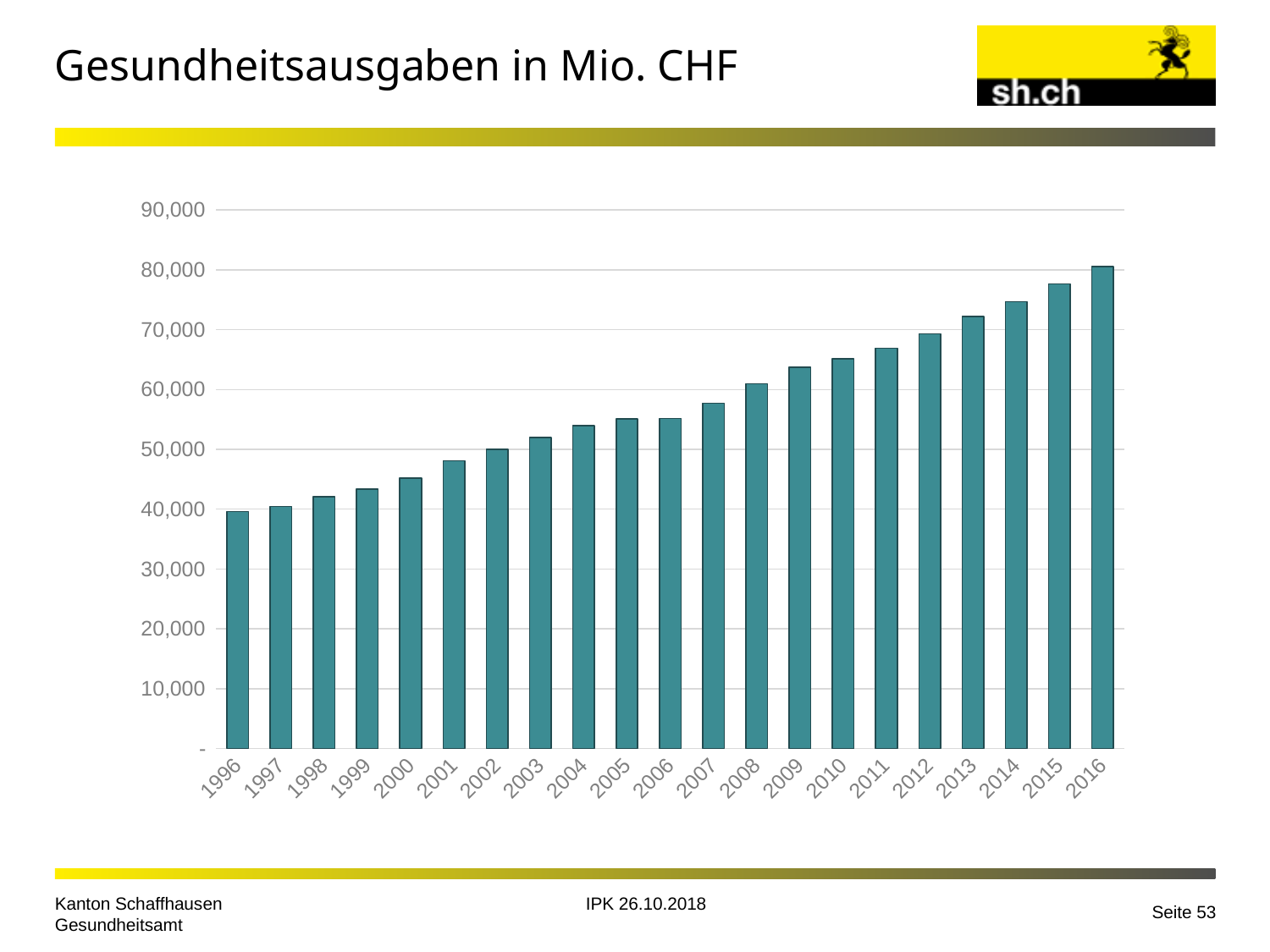
What kind of chart is shown on the slide? bar chart Do the values rise or fall from 1996 to 2016? rise Which year has the highest value in the chart? 2016 Is the value for 2013 greater or less than 70,000? greater Is the value for 2001 greater or less than 50,000? less Is the value for 2008 greater or less than 60,000? greater How many years are shown on the x axis of the chart? 21 What is the title of the slide containing the chart? Gesundheitsausgaben in Mio. CHF Which year has the lowest value in the chart? 1996 Which is larger, the value for 2010 or the value for 2005? 2010